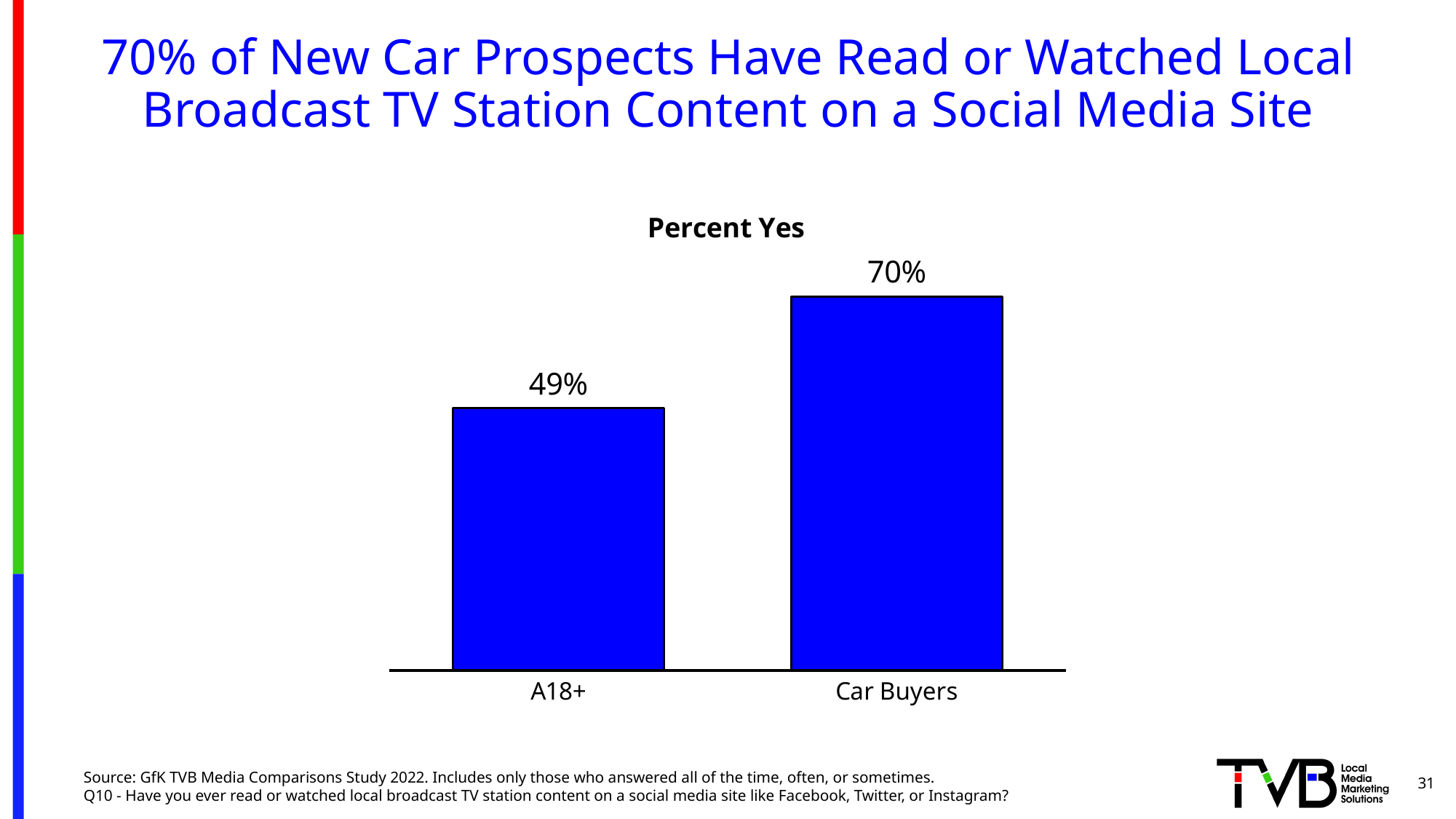
Do the values rise or fall from A18+ to Car Buyers? Rise What is the value for Car Buyers? 70% What kind of chart is shown on the slide? Bar chart What colour are the bars in the chart? Blue Which category has the lowest value? A18+ Which is larger, the value for A18+ or the value for Car Buyers? Car Buyers What is the value for A18+? 49% How many categories are shown in the chart? 2 What is the title of the chart? Percent Yes What is the difference between the values for Car Buyers and A18+? 21% Which category has the highest value? Car Buyers